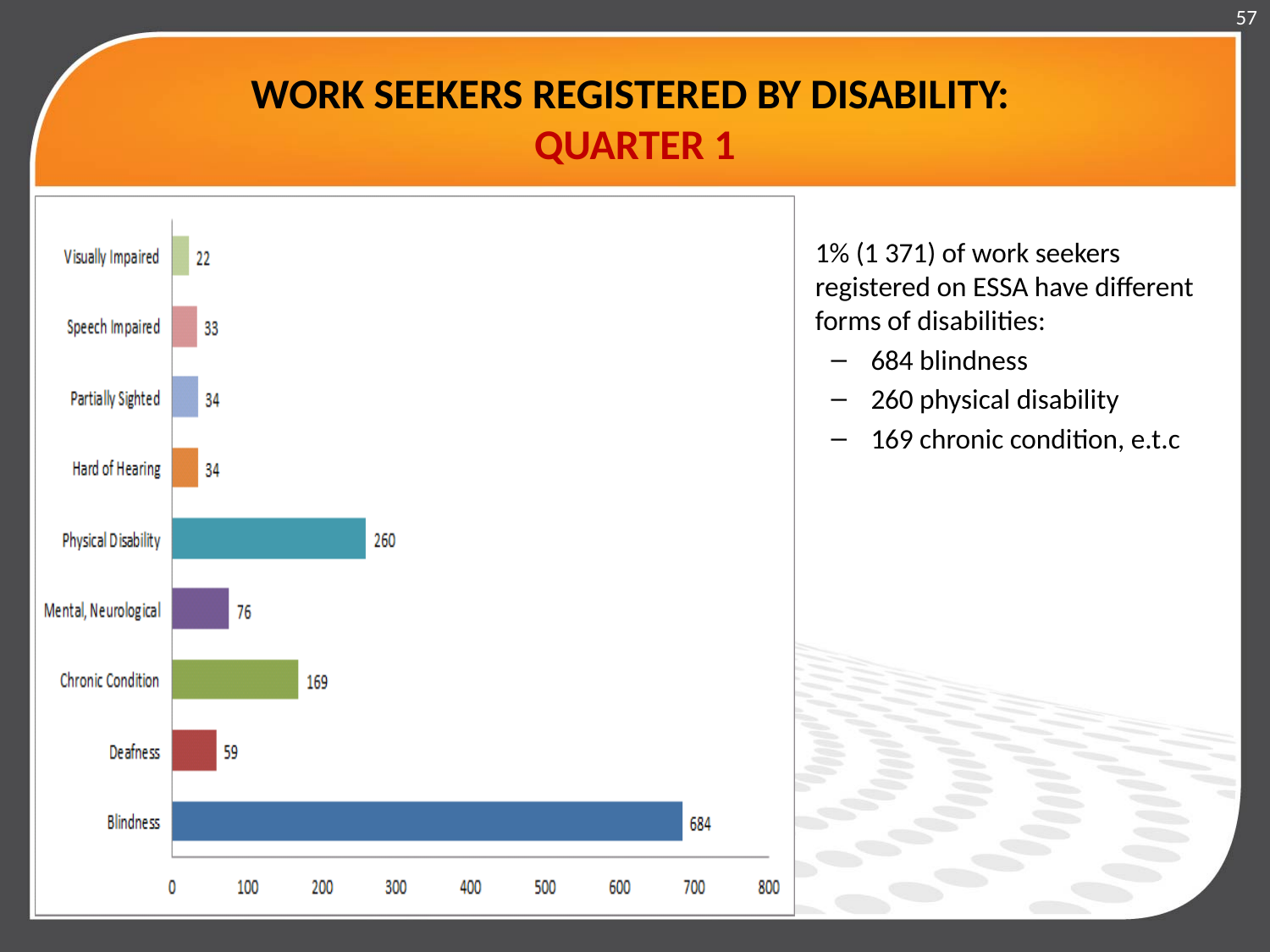
Which category has the highest value? Blindness Which category has the lowest value? Visually Impaired What is the difference between the values for Blindness and Physical Disability? 424 What kind of chart is shown on the slide? Bar chart What is the value for Blindness? 684 Is the value for Chronic Condition greater or less than 200? less What is the difference between the values for Chronic Condition and Deafness? 110 What is the value for Mental, Neurological? 76 Which is larger, the value for Deafness or the value for Speech Impaired? Deafness How many categories are shown in the chart? 9 What is the value for Visually Impaired? 22 What is the value for Physical Disability? 260